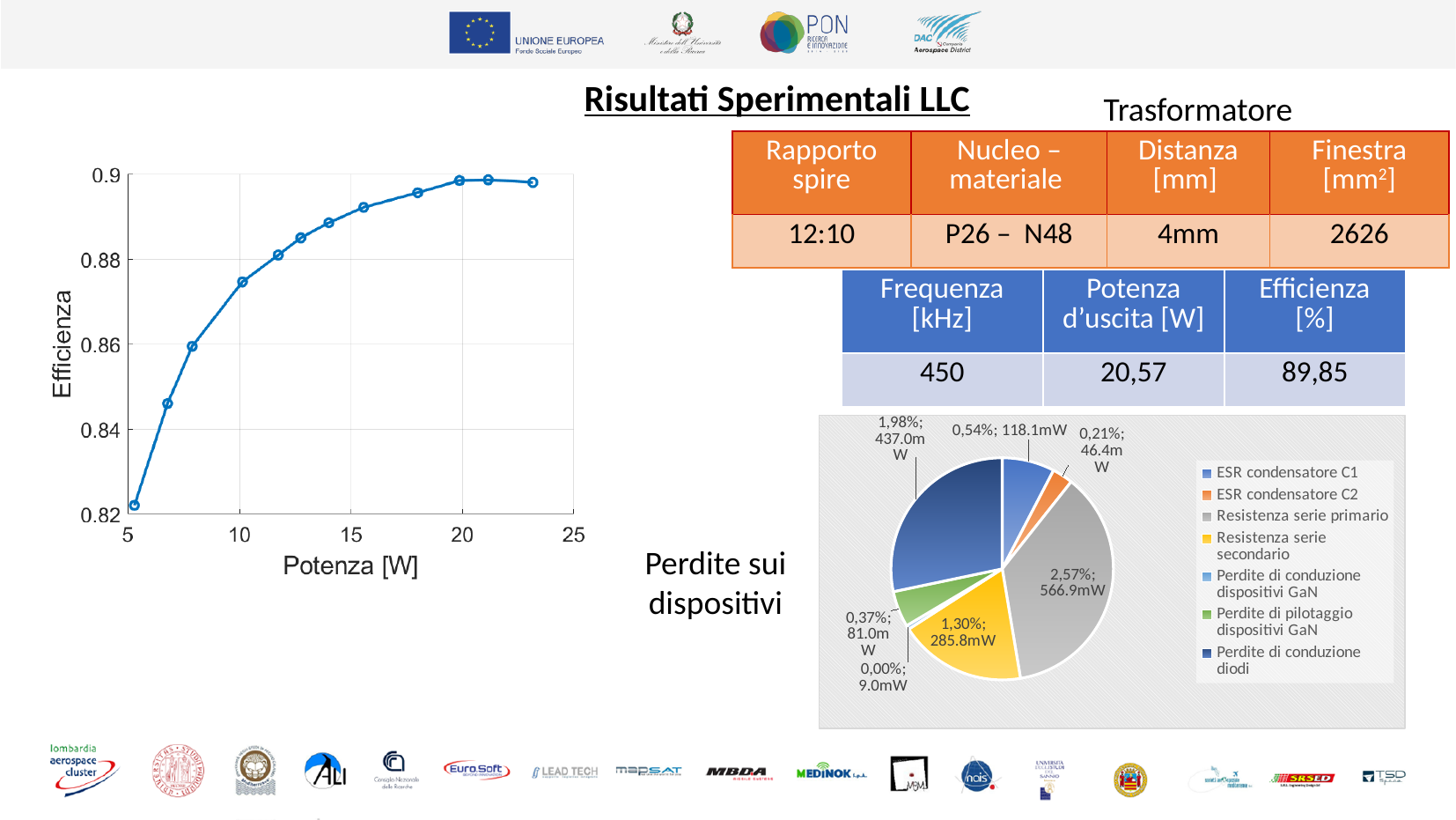
In the 'Perdite sui dispositivi' pie chart, what percentage is shown for Perdite di conduzione diodi? 1,98% How many entries does the legend of the 'Perdite sui dispositivi' pie chart list? 7 In the 'Perdite sui dispositivi' pie chart, what is the loss value for Resistenza serie primario? 566.9mW In the 'Perdite sui dispositivi' pie chart, which category has the largest slice? Resistenza serie primario What kind of chart is the 'Perdite sui dispositivi' chart? pie chart In the left line chart, is the efficiency at about 20 W greater or less than 0.88? greater In the left line chart, is the efficiency at the lowest plotted power (about 5 W) greater or less than 0.84? less What kind of chart is the chart on the left with axes Potenza [W] and Efficienza? line chart In the 'Perdite sui dispositivi' pie chart, which category has the smallest slice? Perdite di conduzione dispositivi GaN In the left line chart, is the efficiency at about 10 W greater or less than 0.86? greater In the 'Perdite sui dispositivi' pie chart, which is larger: ESR condensatore C1 or ESR condensatore C2? ESR condensatore C1 In the left line chart, does the efficiency rise or fall as Potenza increases from 5 W to 20 W? rise